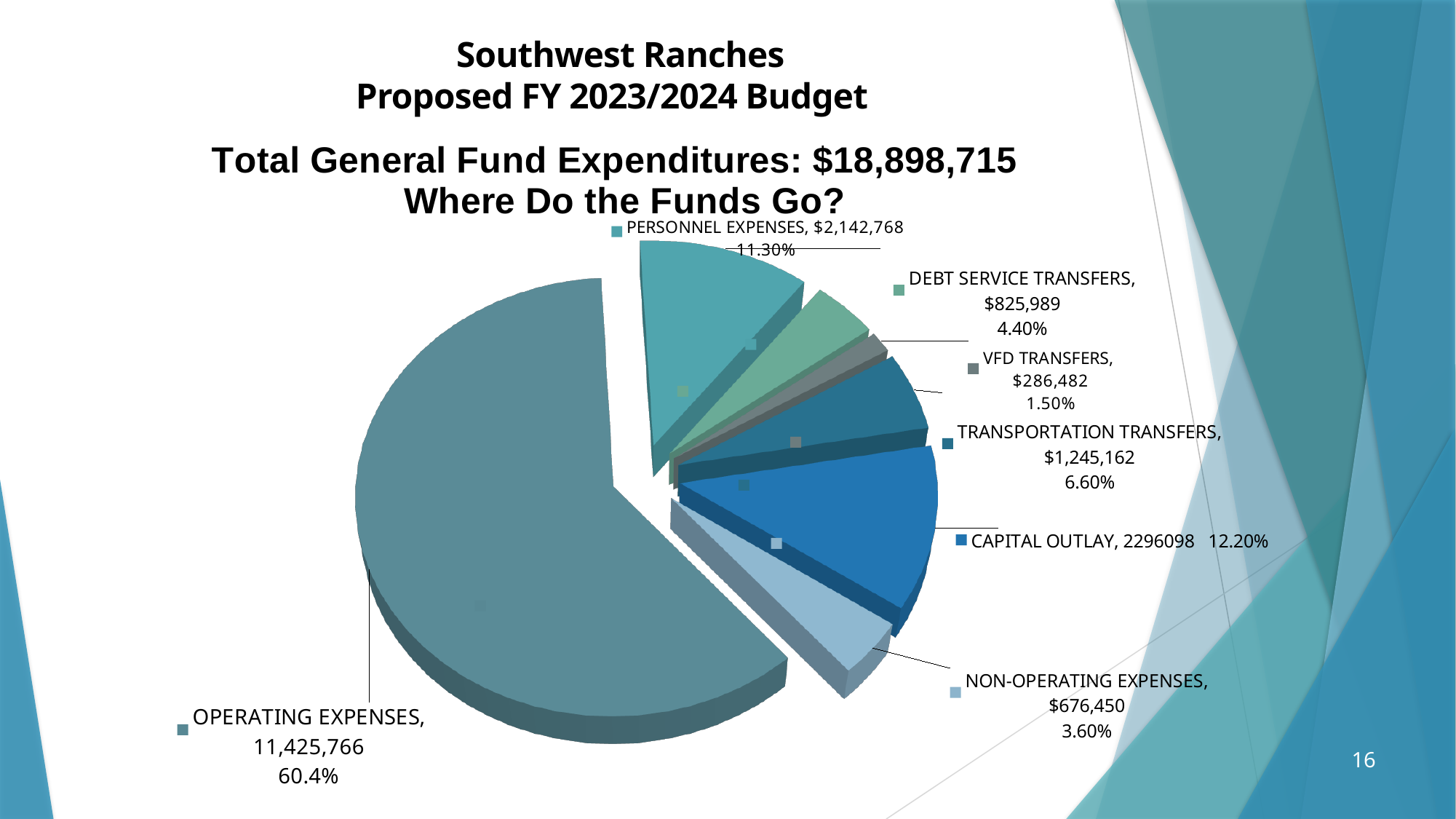
What is the difference between the Capital Outlay value and the Personnel Expenses value? 153,330 What percentage share is shown for VFD Transfers? 1.50% Which category has the smallest slice of the pie? VFD Transfers Which category has the largest slice of the pie? Operating Expenses What kind of chart is shown on the slide? pie chart What is the value shown for Personnel Expenses? $2,142,768 What percentage share is shown for Operating Expenses? 60.4% How many slices does the pie chart have? 7 Which is larger, Debt Service Transfers or Non-Operating Expenses? Debt Service Transfers What percentage share is shown for Capital Outlay? 12.20% What total general fund expenditure amount is stated in the chart title? $18,898,715 What is the value shown for Transportation Transfers? $1,245,162